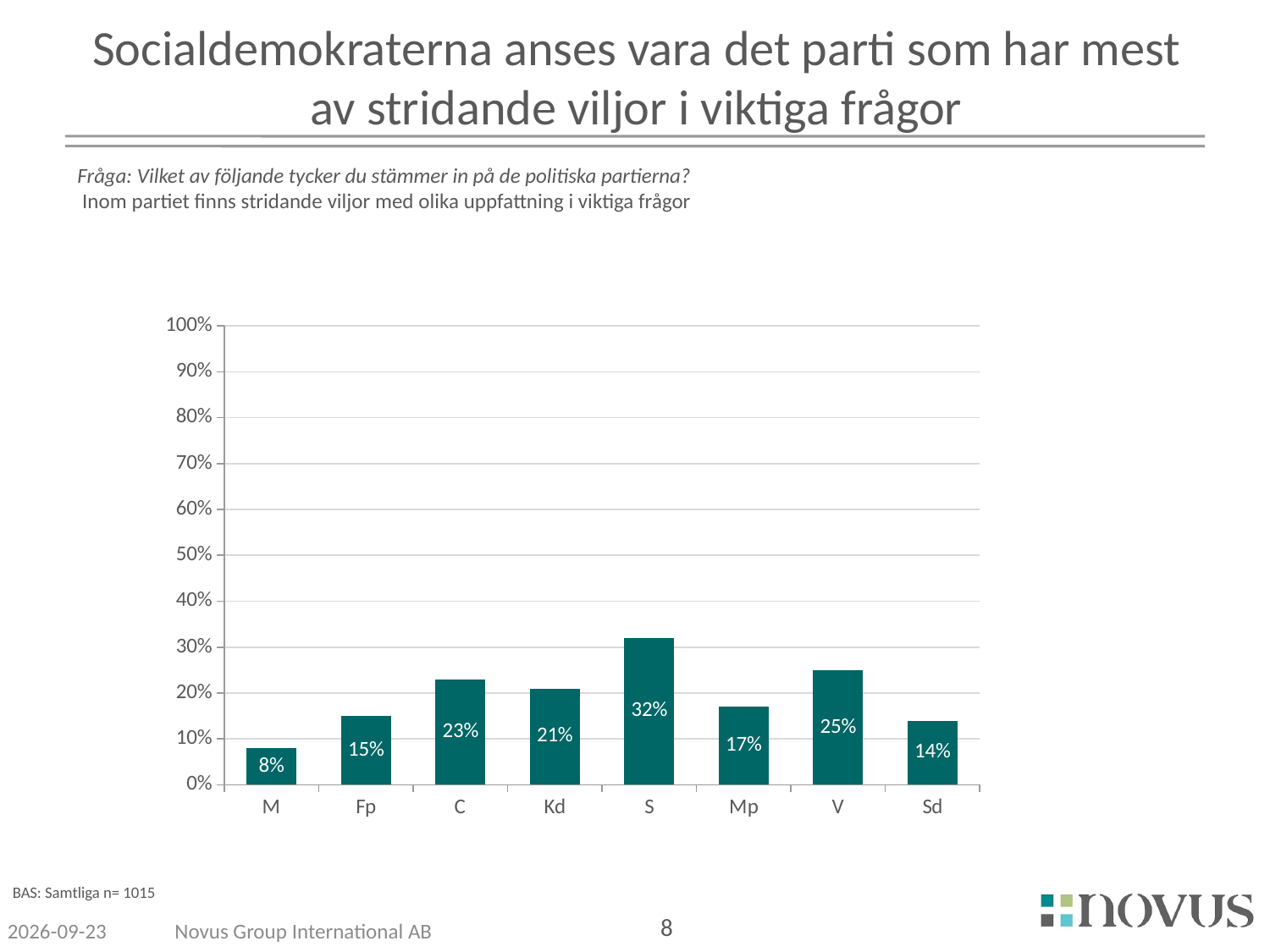
What is the value for Kd? 21% What kind of chart is shown on the slide? bar chart How many parties are shown on the x axis? 8 What is the value for S? 32% What is the difference between the values for S and V? 7% Which party has the lowest value? M Which party has the highest value? S What is the value for M? 8% Is the value for V greater or less than 20%? greater What is the difference between the values for C and Fp? 8% What is the highest value shown on the y axis? 100% Which is larger, the value for Mp or the value for Sd? Mp